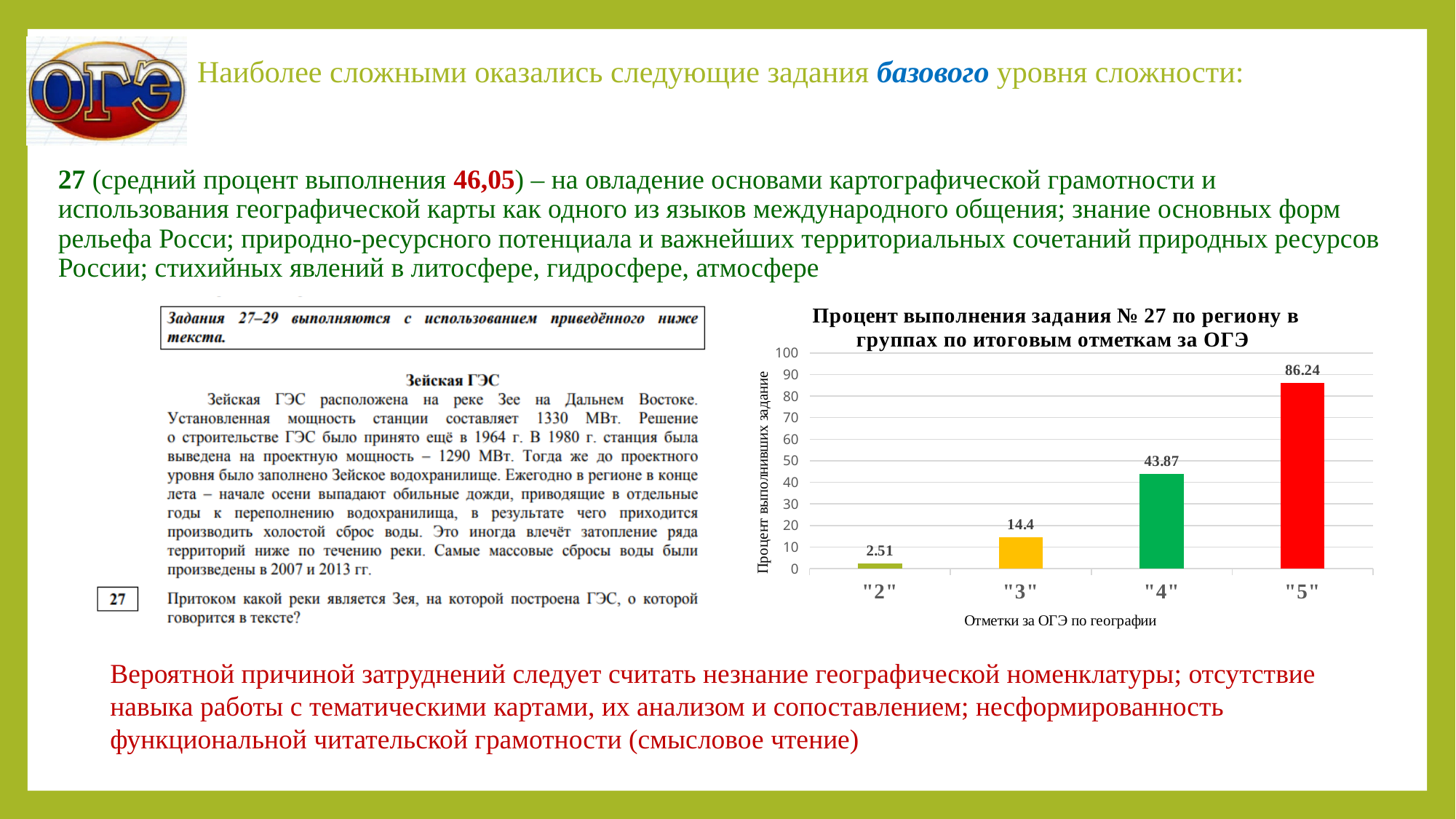
What is the value for the "3" grade group in the chart? 14.4 What is the value for the "2" grade group in the chart? 2.51 Which grade group has the highest percentage of completion in the chart? "5" What kind of chart is shown on the slide? Bar chart What is the value for the "4" grade group in the chart? 43.87 What is the value for the "5" grade group in the chart? 86.24 What is the difference between the values for the "5" and "4" grade groups? 42.37 How many grade groups are shown on the x axis of the chart? 4 What is the label of the x axis of the chart? Отметки за ОГЭ по географии Which is larger: the value for the "3" group or the "4" group? "4" Which grade group has the lowest percentage of completion in the chart? "2" Do the values rise or fall as the grade increases from "2" to "5"? Rise